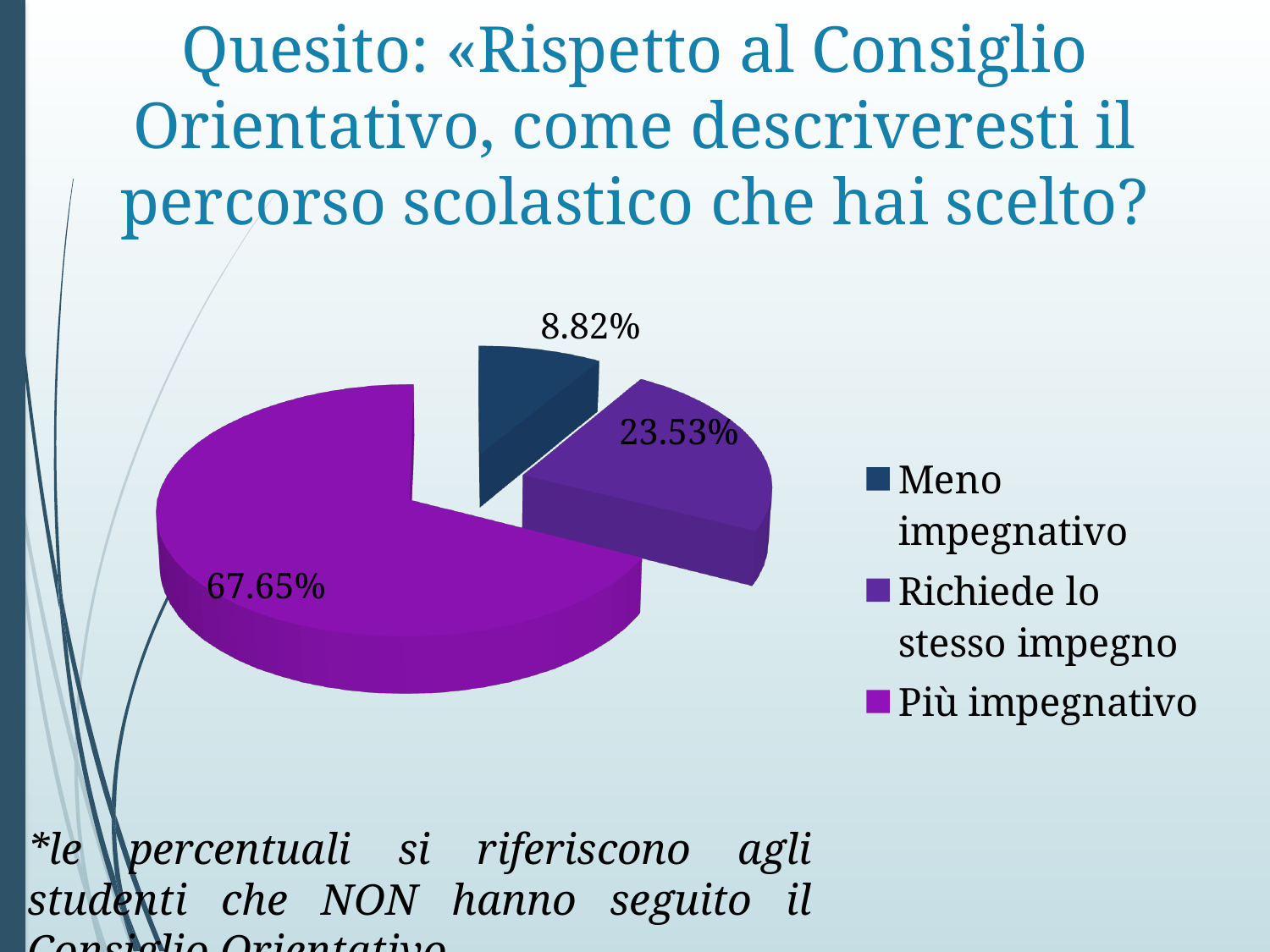
Which category has the smallest slice of the pie? Meno impegnativo Which is larger: the slice for "Richiede lo stesso impegno" or the slice for "Meno impegnativo"? Richiede lo stesso impegno What percentage of the pie is labelled "Richiede lo stesso impegno"? 23.53% What percentage of the pie is labelled "Meno impegnativo"? 8.82% What is the combined percentage of "Meno impegnativo" and "Richiede lo stesso impegno"? 32.35% What kind of chart is shown on the slide? pie chart What percentage of the pie is labelled "Più impegnativo"? 67.65% How many slices does the pie chart have? 3 Which category has the largest slice of the pie? Più impegnativo What is the difference in percentage points between "Più impegnativo" and "Richiede lo stesso impegno"? 44.12 How many entries does the legend list? 3 What colour is the slice for "Più impegnativo"? purple (magenta)